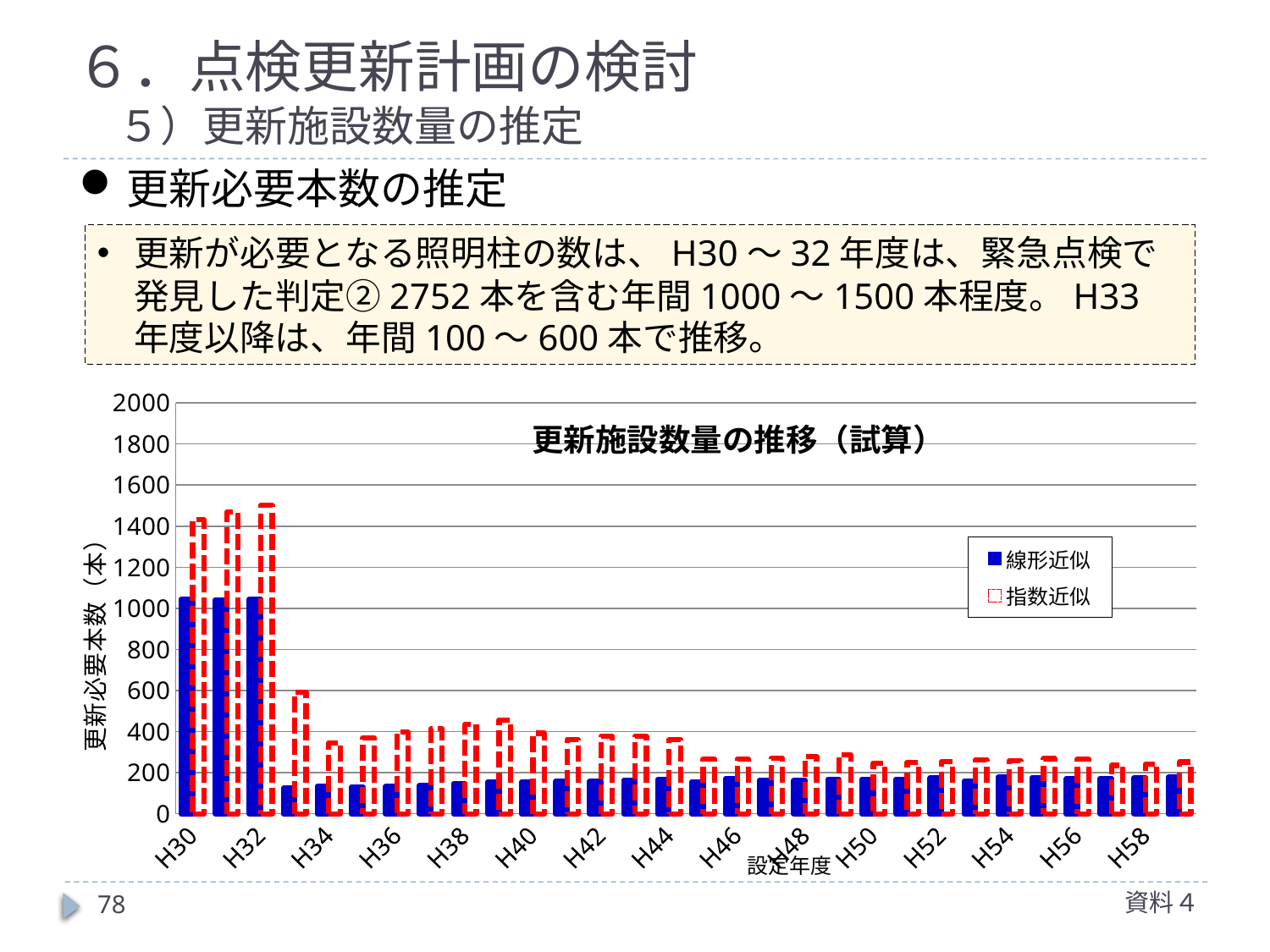
What are the two series named in the chart legend? 線形近似 and 指数近似 What is the title of the chart? 更新施設数量の推移（試算） Do the 線形近似 values rise or fall from H32 to H33? fall Is the 指数近似 value for H30 greater or less than 1200? greater What kind of chart is shown on the slide? bar chart At H30, which series has the larger value, 線形近似 or 指数近似? 指数近似 How many series does the chart legend list? 2 Which series has the larger value at H32, 線形近似 or 指数近似? 指数近似 Do the 指数近似 values generally rise or fall from H33 to H58? fall Is the 指数近似 value for H58 greater or less than 400? less Is the 線形近似 value for H30 greater or less than 800? greater